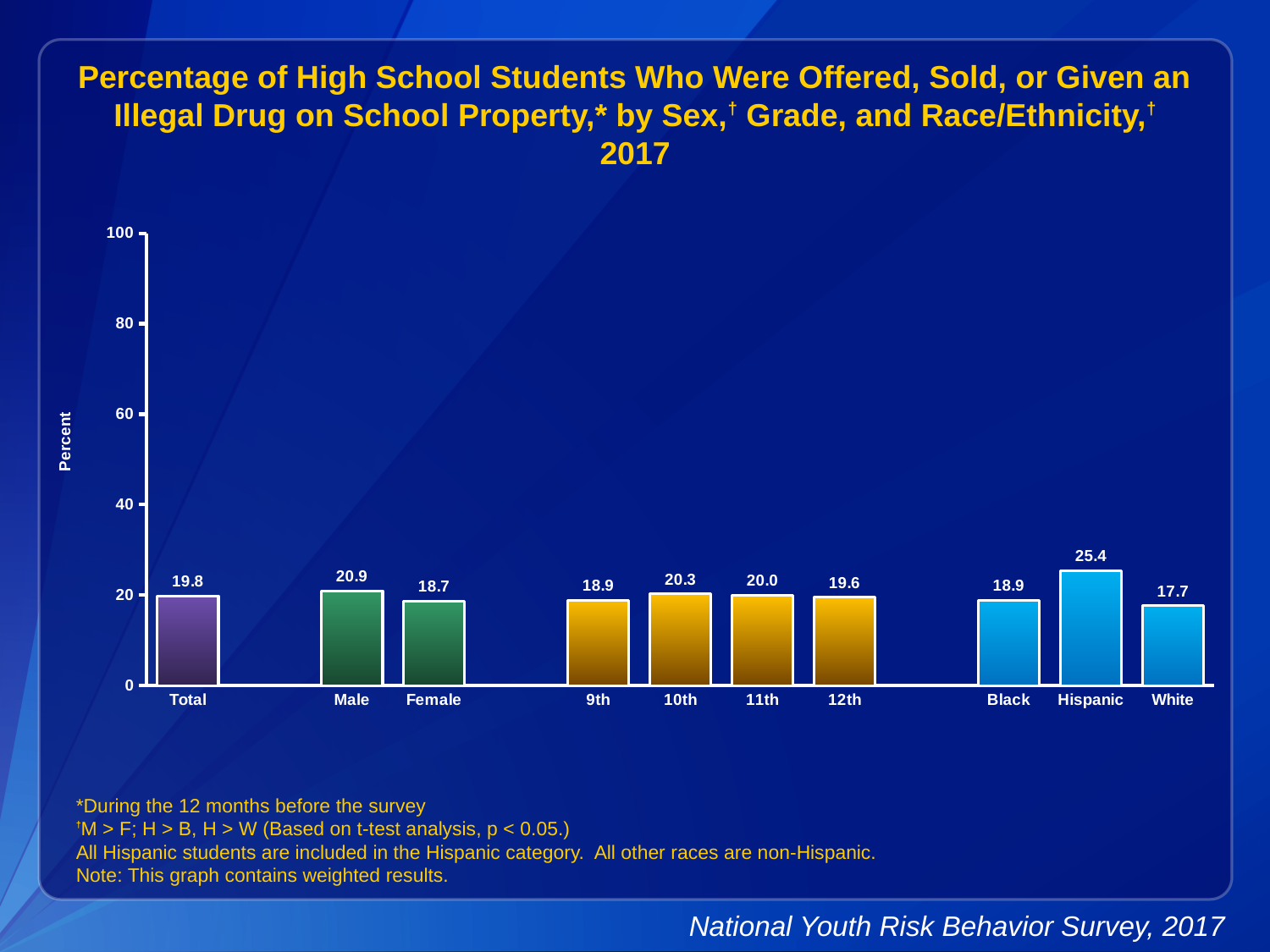
Which is larger, the value for 9th grade or the value for 12th grade? 12th Which category has the lowest value? White How many categories are shown on the x axis? 10 What is the value for Hispanic students? 25.4 What is the difference between the Hispanic and White values? 7.7 Which category has the highest value? Hispanic Is the value for Hispanic greater or less than 20? greater What is the difference between the Male and Female values? 2.2 What is the value for 10th grade? 20.3 What is the value for Total? 19.8 What is the label on the y axis? Percent What kind of chart is this? bar chart